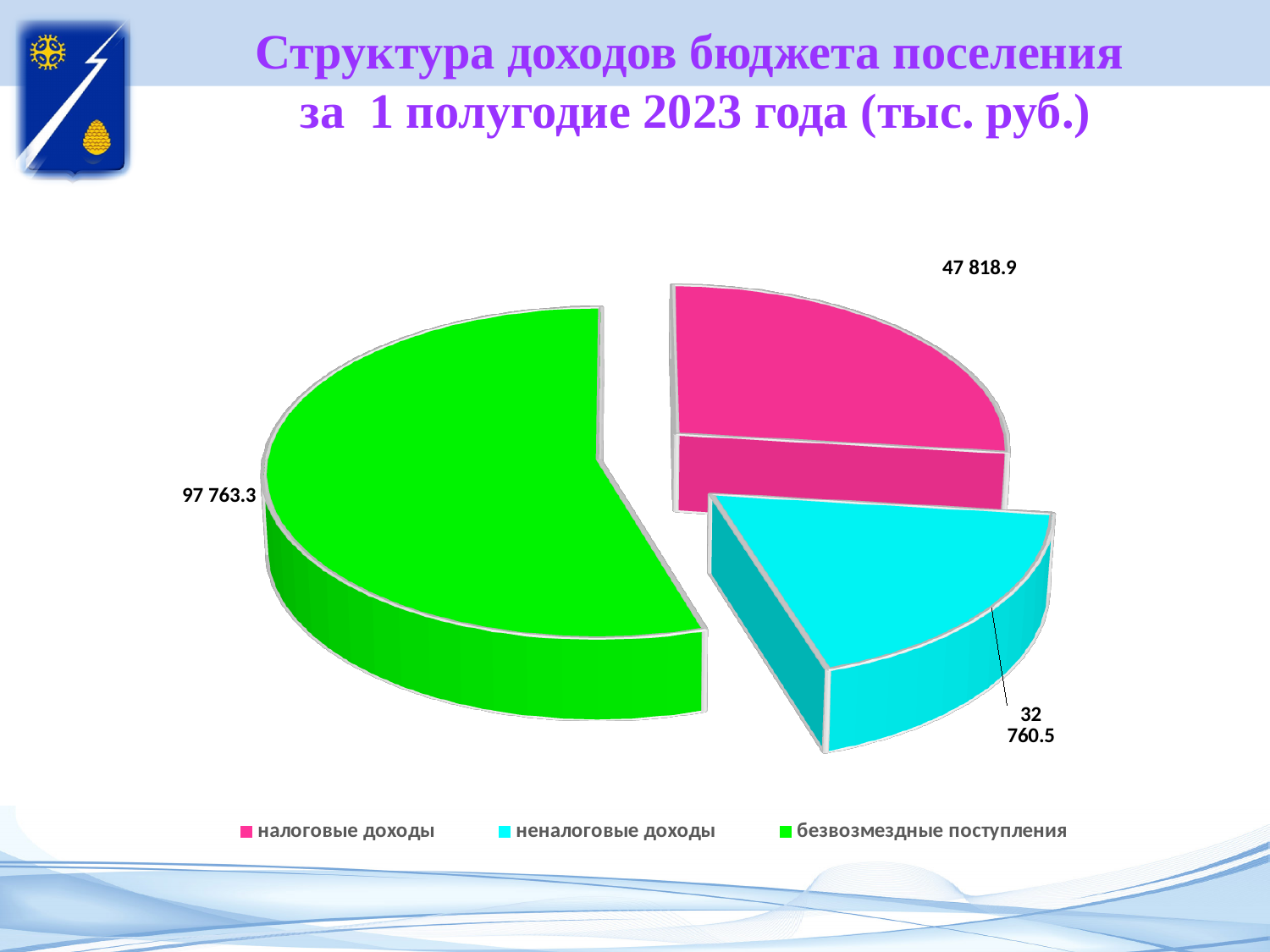
Which category has the smallest slice of the pie? неналоговые доходы Which category has the largest slice of the pie? безвозмездные поступления How many categories does the pie chart have? 3 What is the value for неналоговые доходы? 32 760.5 What is the difference between налоговые доходы and неналоговые доходы? 15 058.4 Which colour represents неналоговые доходы in the legend? cyan What is the value for налоговые доходы? 47 818.9 Which is larger, налоговые доходы or неналоговые доходы? налоговые доходы What is the difference between безвозмездные поступления and налоговые доходы? 49 944.4 What share of the total do безвозмездные поступления represent? 54.8% What type of chart is shown on the slide? pie chart What is the value for безвозмездные поступления? 97 763.3